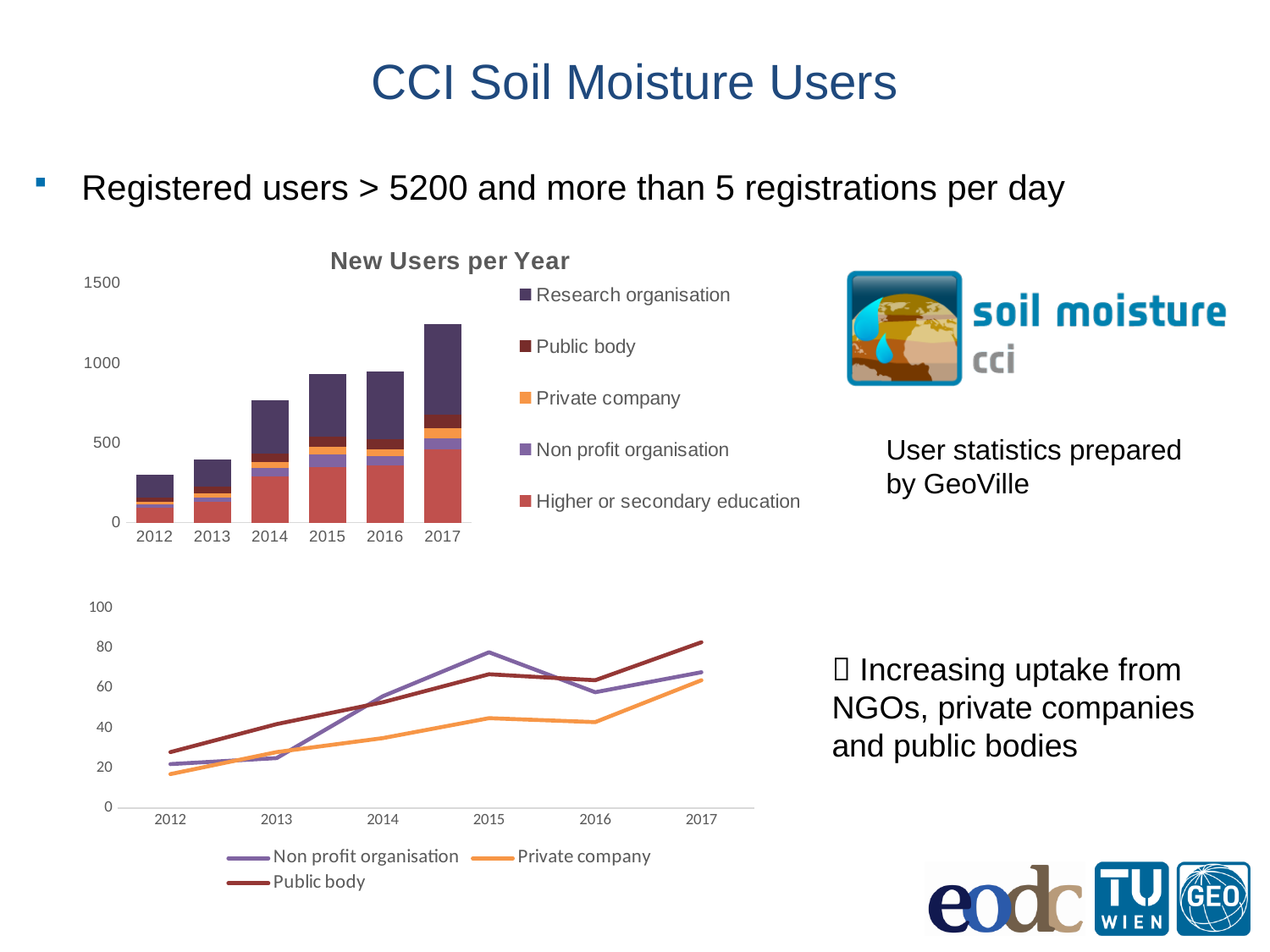
In the bottom line chart, which series has the highest value in 2017? Public body What kind of chart is the bottom chart on the slide? line chart In the "New Users per Year" chart, is the total for 2017 greater or less than 1000? greater In the "New Users per Year" chart, how many years are shown on the x axis? 6 In the bottom line chart, which series has the lowest value in 2012? Private company In the "New Users per Year" chart, which year has the tallest stacked bar? 2017 What kind of chart is the top chart titled "New Users per Year"? bar chart In the "New Users per Year" chart, is the total for 2012 greater or less than 500? less In the bottom line chart, how many series does the legend list? 3 In the bottom line chart, is the value for Non profit organisation in 2015 greater or less than 60? greater In the "New Users per Year" chart, how many series does the legend list? 5 In the "New Users per Year" chart, which year has the shortest stacked bar? 2012